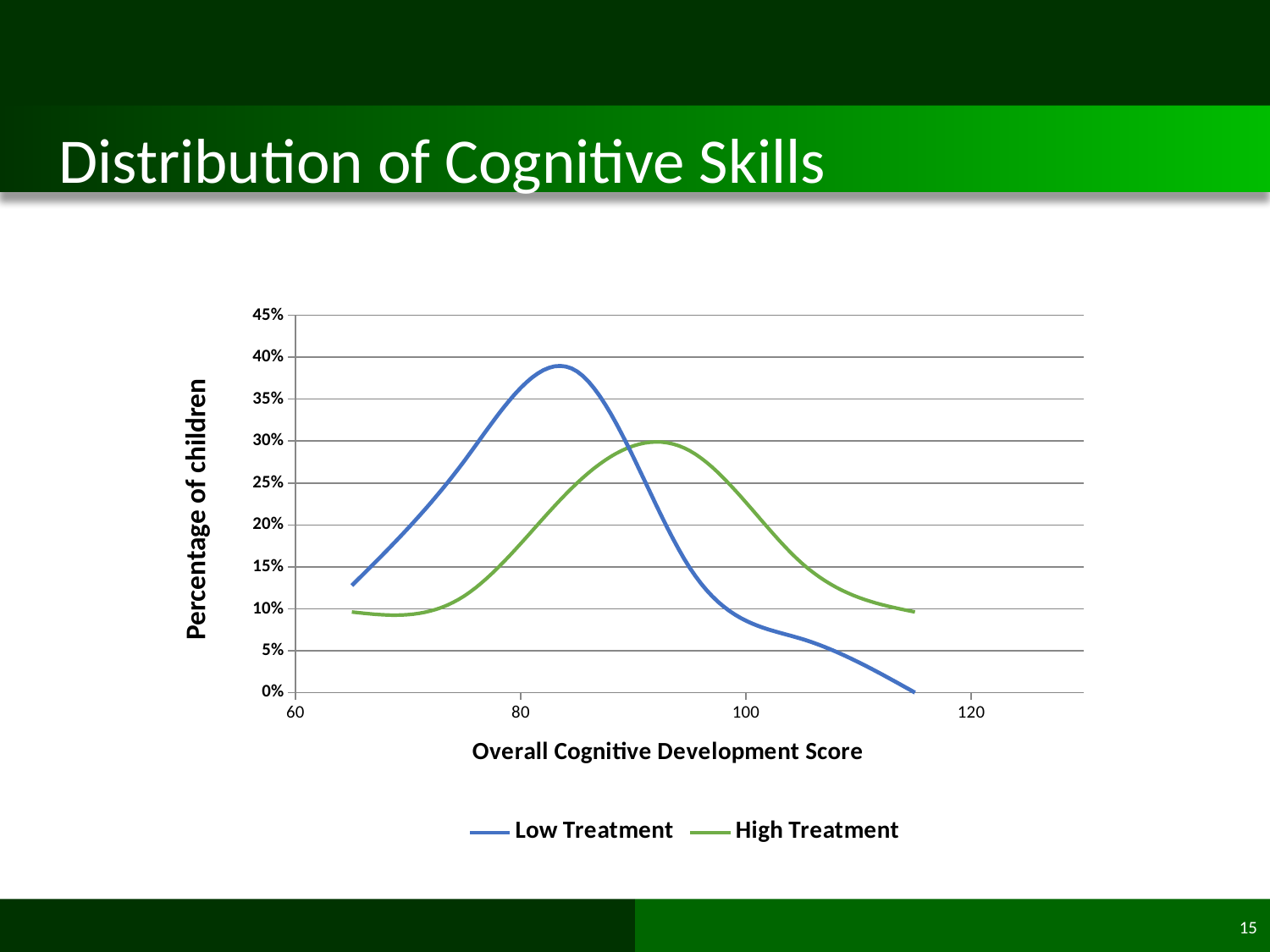
At a score of 100, which series has the higher percentage of children, Low Treatment or High Treatment? High Treatment What are the two series named in the legend? Low Treatment and High Treatment Which series reaches the higher peak, Low Treatment or High Treatment? Low Treatment What kind of chart is shown on the slide? Line chart Is the peak value of the Low Treatment line greater or less than 35%? greater Is the peak value of the High Treatment line greater or less than 25%? greater Does the Low Treatment line rise or fall as the score increases from 100 to 115? fall At a score of 80, which series has the higher percentage of children, Low Treatment or High Treatment? Low Treatment Is the value of the Low Treatment line at a score of 100 greater or less than 10%? less How many series does the legend list? 2 Does the High Treatment line rise or fall as the score increases from 70 to 90? rise What is the title of the x axis? Overall Cognitive Development Score